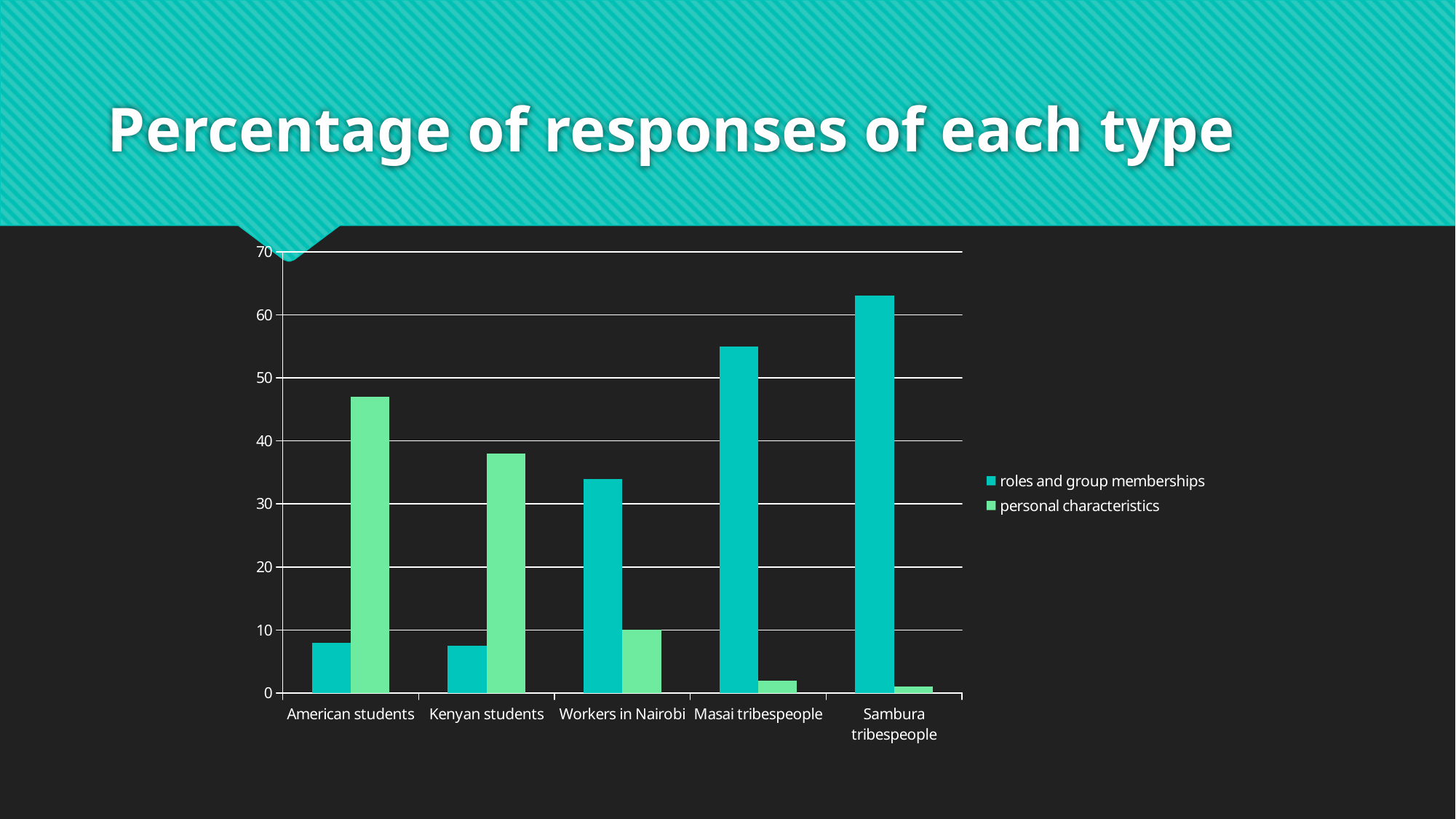
For Workers in Nairobi, which is larger: roles and group memberships or personal characteristics? roles and group memberships Is the value for roles and group memberships for American students greater or less than 10? less How many categories are shown on the x axis? 5 What is the title of the chart? Percentage of responses of each type Which category has the highest value for roles and group memberships? Sambura tribespeople Which category has the highest value for personal characteristics? American students Do the values for roles and group memberships rise or fall moving from left to right across the categories? rise How many series does the legend list? 2 Is the value for roles and group memberships for Masai tribespeople greater or less than 50? greater Is the value for personal characteristics for Kenyan students greater or less than 40? less What kind of chart is shown on the slide? bar chart Which category has the lowest value for personal characteristics? Sambura tribespeople